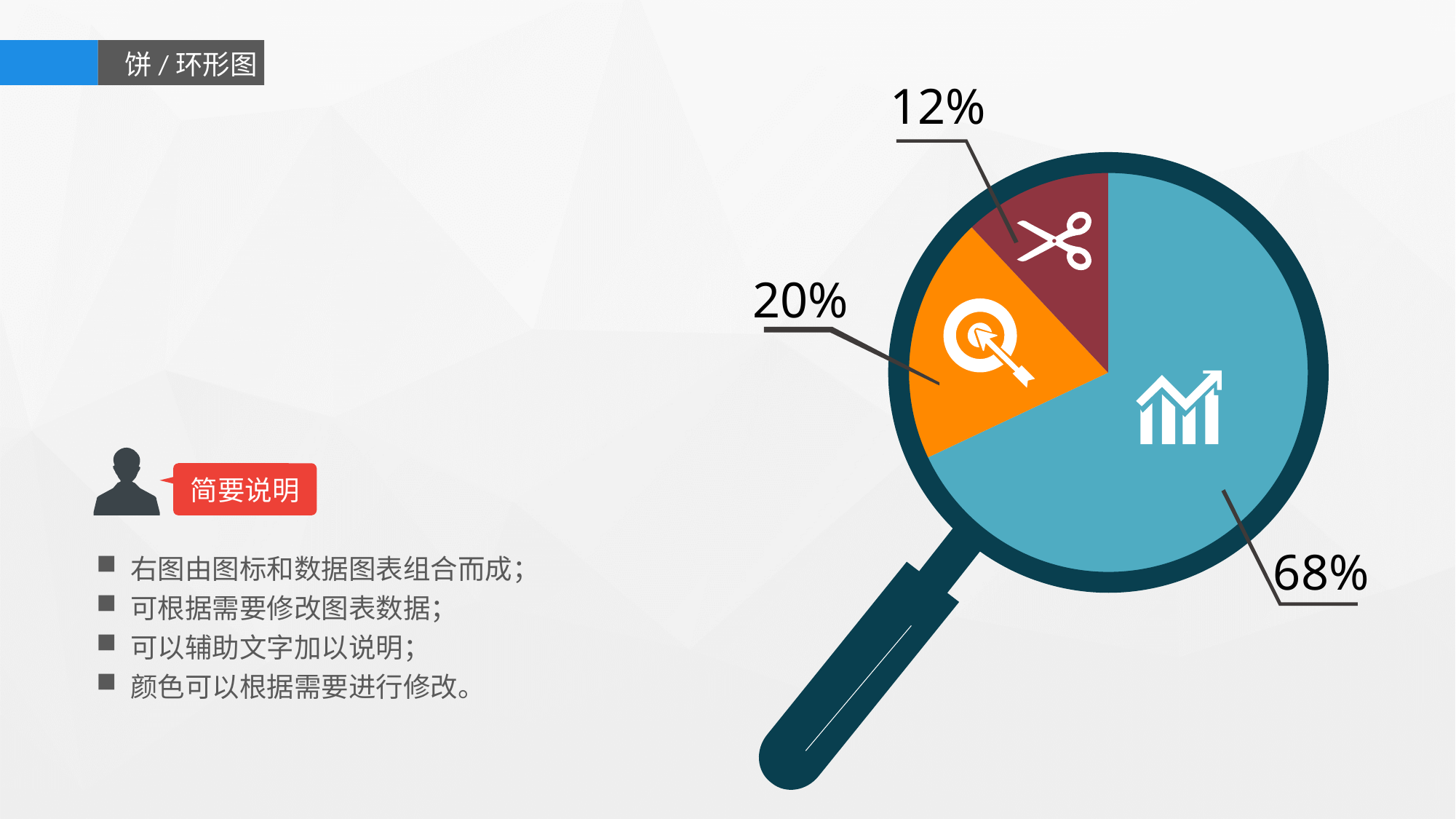
Which slice of the pie chart is the largest? the blue slice (68%) What do the three slice percentages add up to? 100% What is the difference between the orange slice and the dark red slice? 8% Which is larger, the orange slice or the dark red slice? the orange slice Which slice of the pie chart is the smallest? the dark red slice (12%) What colour is the slice labelled 20%? orange What percentage is shown for the blue slice with the bar-chart icon? 68% What percentage is shown for the dark red slice with the scissors icon? 12% What is the difference between the largest slice and the smallest slice? 56% What kind of chart is shown inside the magnifying glass? pie chart What percentage is shown for the orange slice with the target icon? 20% How many slices does the pie chart have? 3